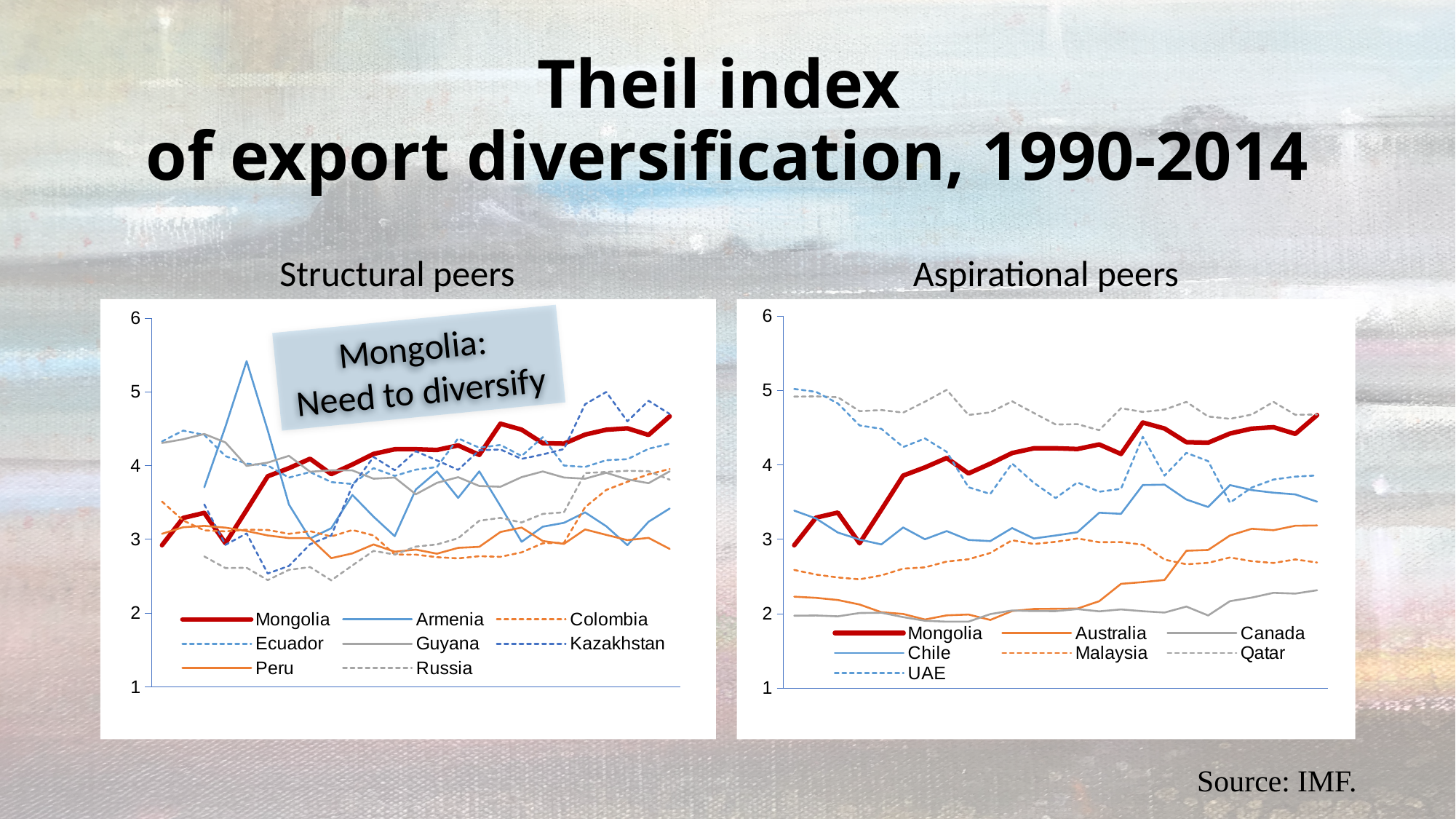
In the Aspirational peers chart, does the Mongolia line rise or fall overall from left to right? rise What kind of chart is the Structural peers chart? line chart In the Structural peers chart, is the peak value of the Armenia line greater or less than 5? greater In the Aspirational peers chart, at the right end of the lines, which is higher: Mongolia or Malaysia? Mongolia In the Aspirational peers chart, is the value for Mongolia at the right end of the line greater or less than 4? greater In the Aspirational peers chart, does the Australia line rise or fall overall from left to right? rise In the Aspirational peers chart, which series is lowest at the right end of the chart? Canada What is the title of the slide? Theil index of export diversification, 1990-2014 What does the annotation box on the Structural peers chart say? Mongolia: Need to diversify In the Aspirational peers chart, is the value for Canada at the right end of the line greater or less than 3? less How many series does the legend of the Structural peers chart list? 8 How many series does the legend of the Aspirational peers chart list? 7